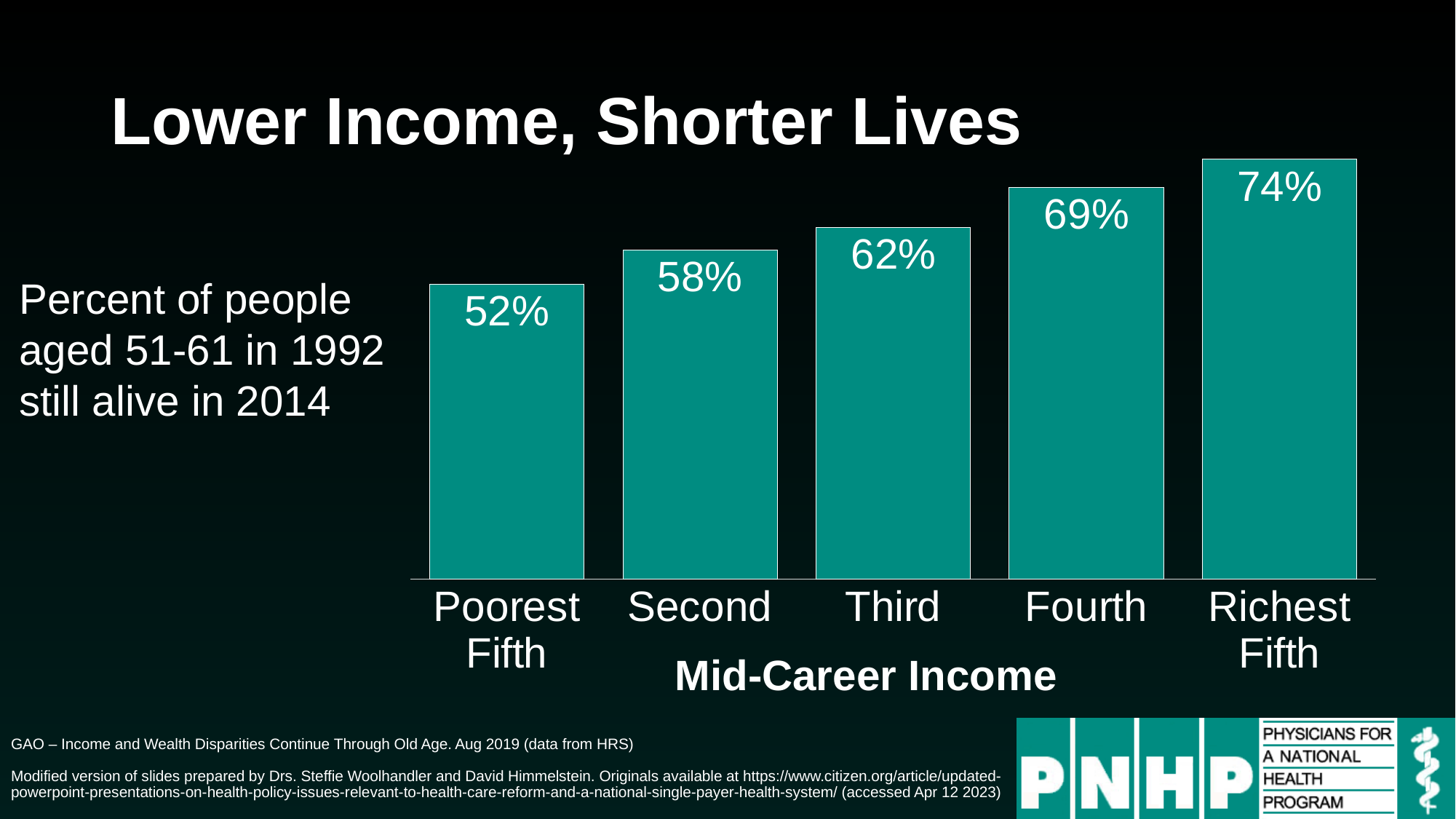
What is the value shown for the Fourth income group? 69% What is the difference in percentage points between the Richest Fifth and the Poorest Fifth? 22 Which is larger, the value for the Second group or the value for the Fourth group? Fourth What is the difference in percentage points between the Second and Third income groups? 4 Do the values rise or fall moving from the Poorest Fifth to the Richest Fifth? Rise What percent of people in the Poorest Fifth were still alive in 2014? 52% Which income group has the highest percentage still alive in 2014? Richest Fifth How many income groups are shown on the chart? 5 What kind of chart is shown on the slide? Bar chart What is the label of the x axis? Mid-Career Income What is the value shown for the Third income group? 62% Which income group has the lowest percentage still alive in 2014? Poorest Fifth